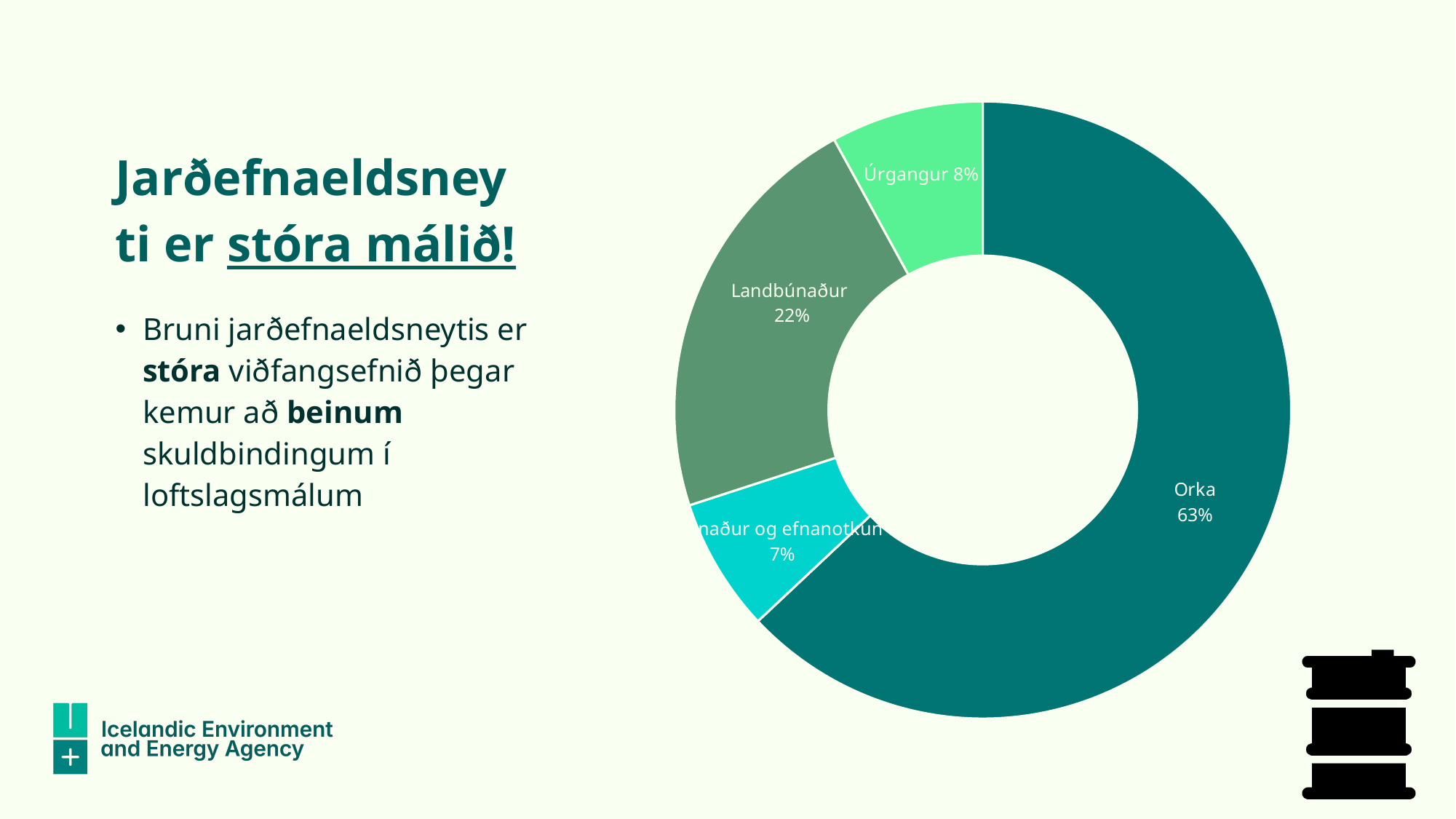
What kind of chart is shown on the slide? Doughnut (pie) chart What percentage is shown for Úrgangur in the chart? 8% What colour is the Orka slice in the chart? Dark teal What is the combined share of Orka and Landbúnaður? 85% Which is larger, the share for Landbúnaður or the share for Úrgangur? Landbúnaður Which is larger, the share for Orka or the share for Landbúnaður? Orka How many slices does the doughnut chart have? 4 How many percentage points larger is Landbúnaður's share than Úrgangur's share? 14 percentage points How many percentage points larger is Orka's share than Landbúnaður's share? 41 percentage points What percentage does the Orka slice show in the doughnut chart? 63% Which category has the largest share in the doughnut chart? Orka What percentage is shown for Landbúnaður in the chart? 22%